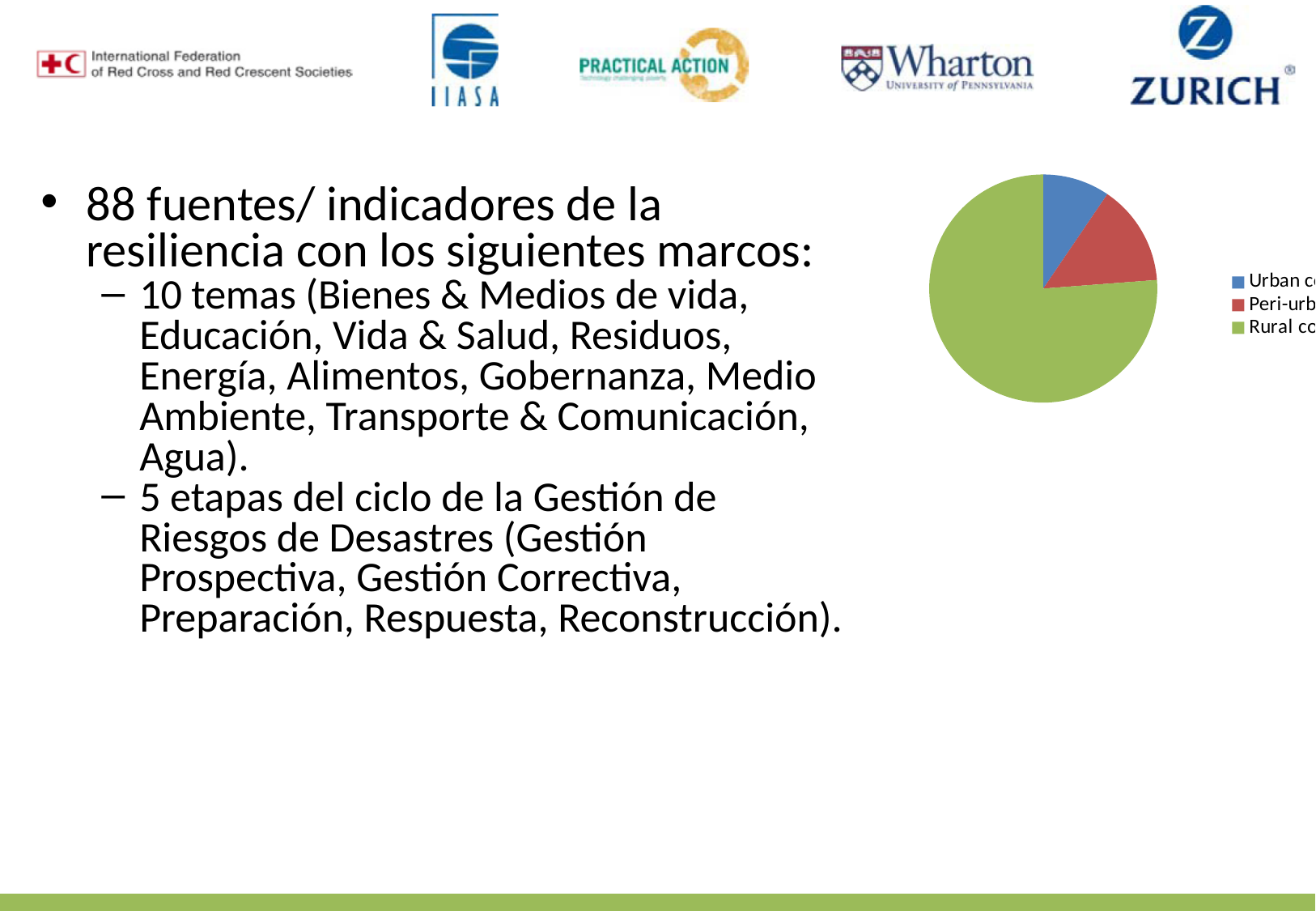
What kind of chart is shown on the right of the slide? pie chart Which category has the largest slice in the pie chart? Rural How many entries does the legend of the pie chart list? 3 What colour is the Urban slice in the pie chart? blue How many slices does the pie chart have? 3 Which category has the smallest slice in the pie chart? Urban In the pie chart, which slice is larger, Rural or Peri-urban? Rural What colour is the Rural slice in the pie chart? green In the pie chart, which slice is larger, Peri-urban or Urban? Peri-urban